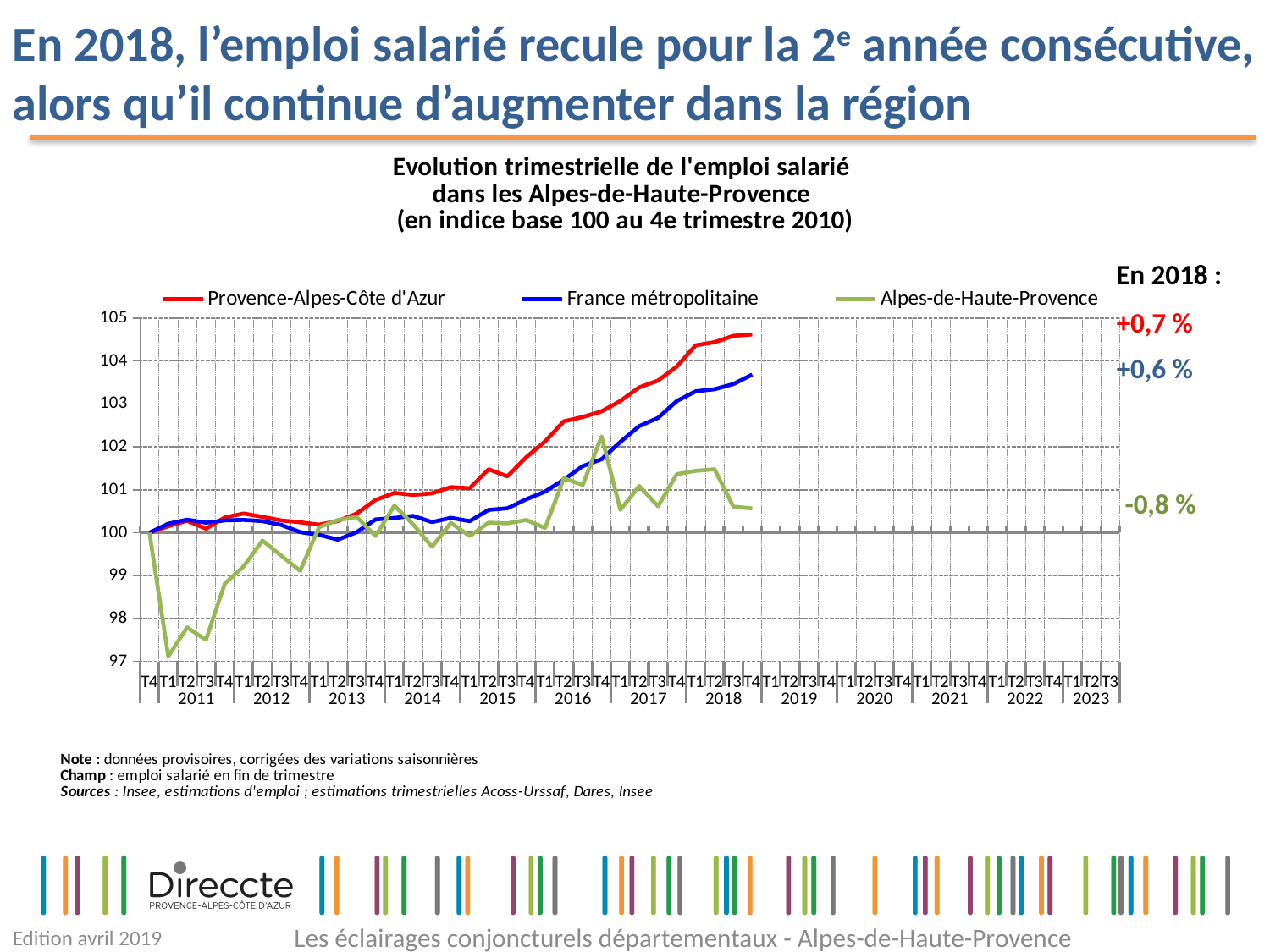
What kind of chart is shown on the slide? line chart What is the 2018 change shown for France métropolitaine? +0,6 % Is the value for Alpes-de-Haute-Provence at T1 2011 greater or less than 98? less How many series does the legend list? 3 Is the value for Provence-Alpes-Côte d'Azur at T4 2018 greater or less than 104? greater Does the Provence-Alpes-Côte d'Azur line generally rise or fall from 2013 to 2018? rise What is the 2018 change shown for Provence-Alpes-Côte d'Azur? +0,7 % Which 2018 change is larger, Provence-Alpes-Côte d'Azur or France métropolitaine? Provence-Alpes-Côte d'Azur Which series has the lowest 2018 change shown on the chart? Alpes-de-Haute-Provence Which series has the highest index value at the end of 2018? Provence-Alpes-Côte d'Azur What is the 2018 change shown for Alpes-de-Haute-Provence? -0,8 % What colour is the Alpes-de-Haute-Provence line? green